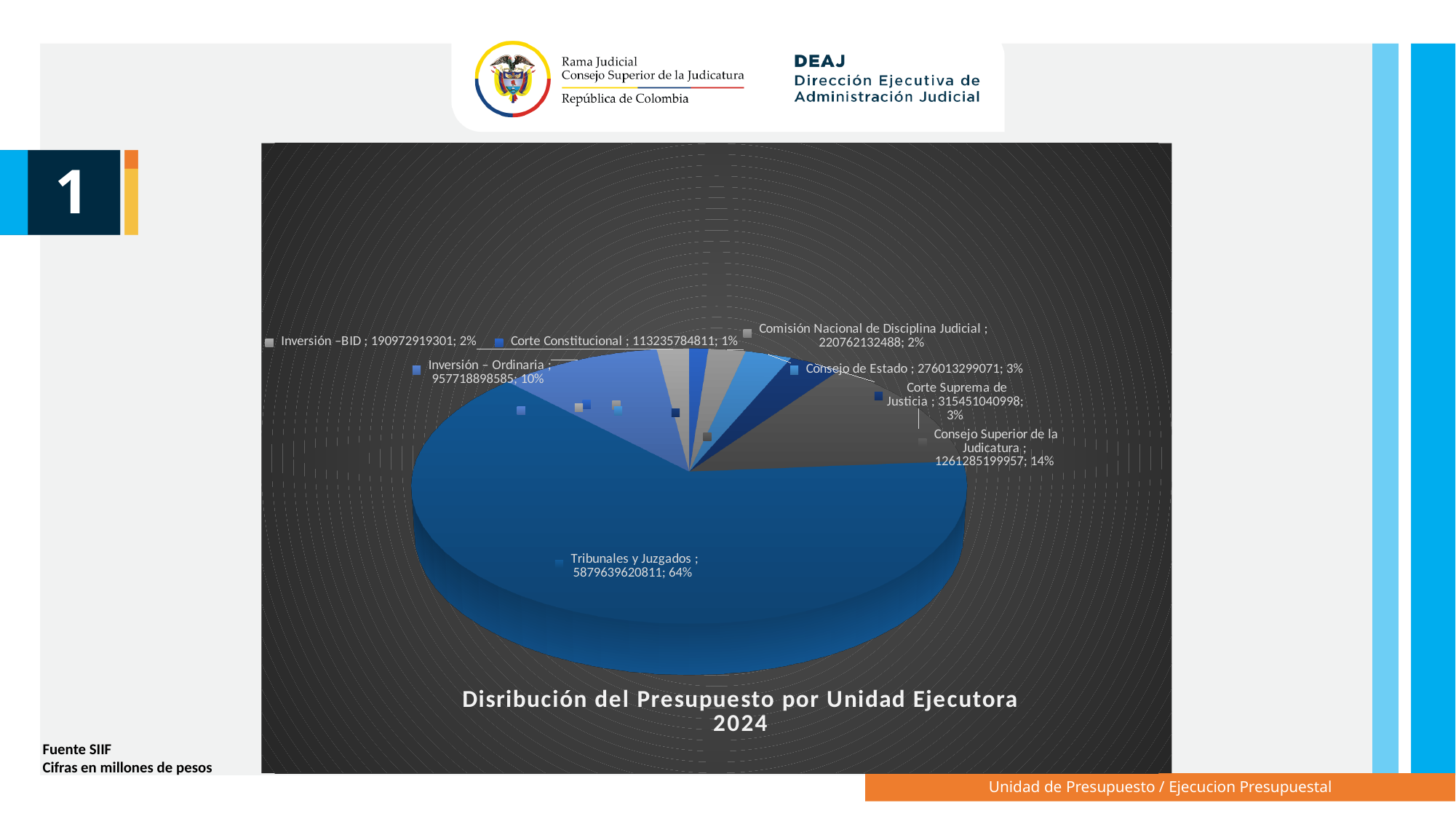
What percentage is shown for Corte Constitucional? 1% Which category has the smallest slice of the pie? Corte Constitucional Which is larger, the value for Consejo de Estado or the value for Corte Suprema de Justicia? Corte Suprema de Justicia What is the difference between the values for Corte Suprema de Justicia and Consejo de Estado? 39437741927 What share of the pie does Tribunales y Juzgados represent? 64% Which category has the largest slice of the pie? Tribunales y Juzgados What is the value shown for Consejo Superior de la Judicatura? 1261285199957 What is the title of the chart? Disribución del Presupuesto por Unidad Ejecutora 2024 What percentage is shown for Comisión Nacional de Disciplina Judicial? 2% What type of chart is shown on the slide? Pie chart What is the value shown for Inversión – Ordinaria? 957718898585 How many slices does the pie chart have? 8